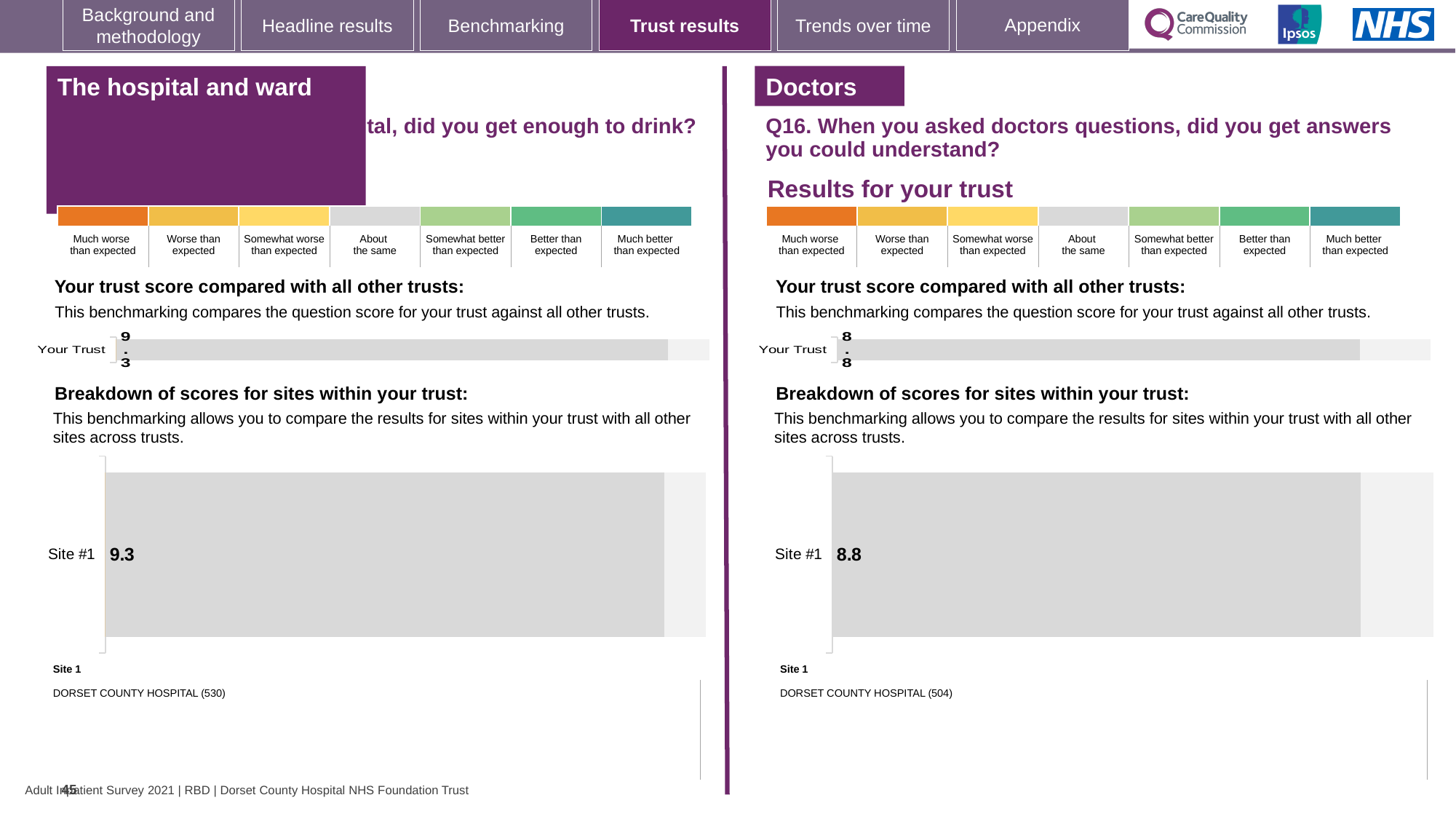
On the left-hand side of the slide (The hospital and ward), what is the score shown for Your Trust in the 'Your trust score compared with all other trusts' chart? 9.3 What kind of chart is used to show the Your Trust score on the left-hand side (The hospital and ward)? Bar chart On the right-hand side of the slide (Q16, Doctors), what is the score shown for Your Trust in the 'Your trust score compared with all other trusts' chart? 8.8 What kind of chart is used to show the Site #1 score in the breakdown section on the right-hand side (Q16)? Bar chart How many sites are plotted in the 'Breakdown of scores for sites within your trust' chart on the right-hand side (Q16)? 1 Which site name is listed as Site 1 beneath the breakdown chart on the right-hand side (Q16)? DORSET COUNTY HOSPITAL (504) In the 'Breakdown of scores for sites within your trust' chart on the left-hand side (The hospital and ward), what is the score for Site #1? 9.3 Which site name is listed as Site 1 beneath the breakdown chart on the left-hand side (The hospital and ward)? DORSET COUNTY HOSPITAL (530) Which is larger: the Your Trust score on the left-hand chart (The hospital and ward) or the Your Trust score on the right-hand chart (Q16, Doctors)? The left-hand chart (9.3) In the 'Breakdown of scores for sites within your trust' chart on the right-hand side (Q16), what is the score for Site #1? 8.8 What is the difference between the Site #1 score on the left-hand breakdown chart (9.3) and the Site #1 score on the right-hand breakdown chart (8.8)? 0.5 How many sites are plotted in the 'Breakdown of scores for sites within your trust' chart on the left-hand side (The hospital and ward)? 1